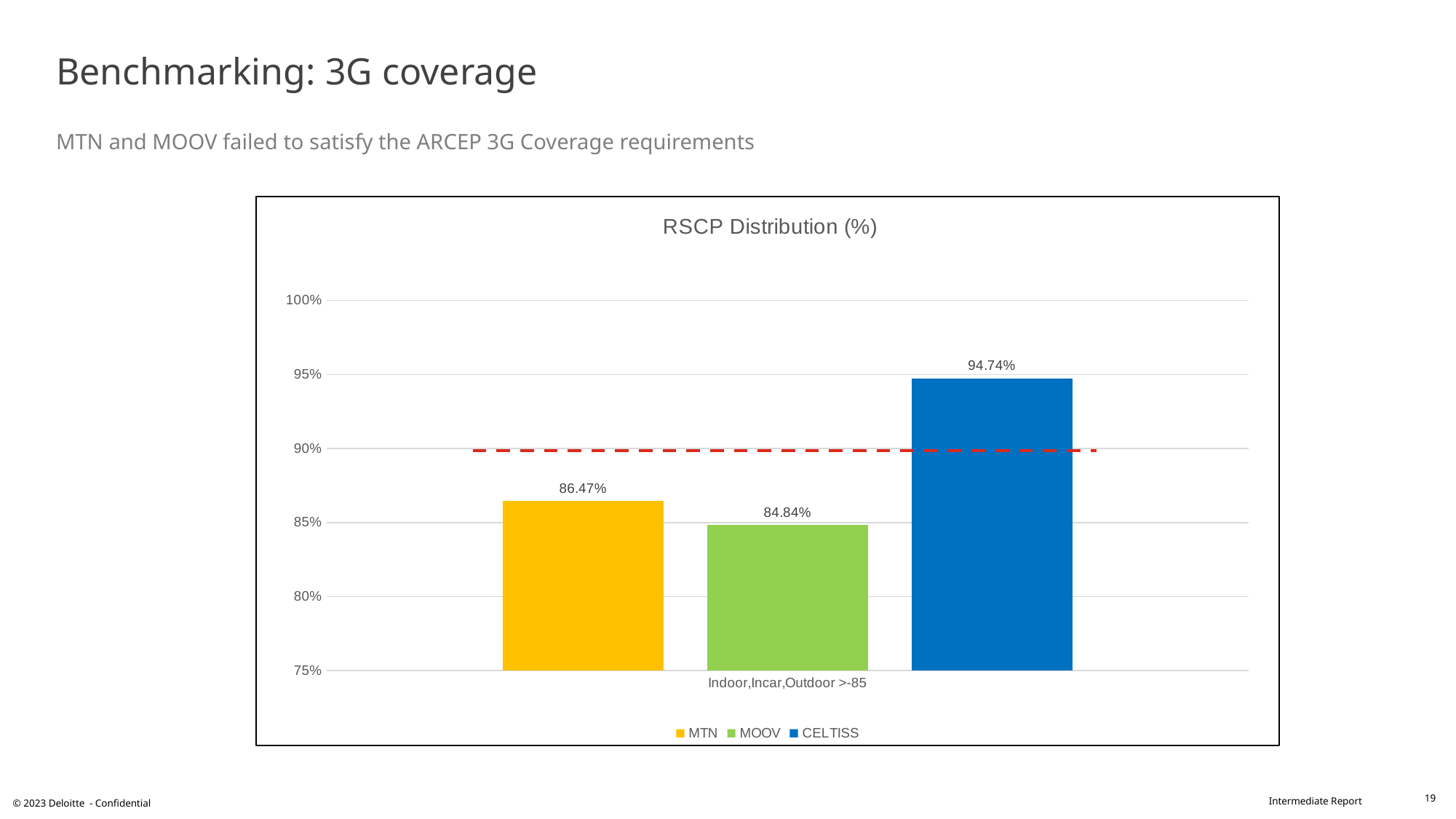
What is the title of the chart? RSCP Distribution (%) Is the value for CELTISS greater or less than 90%? greater Which is larger, the value for MTN or the value for MOOV? MTN What is the RSCP Distribution value for MOOV? 84.84% Which operator has the highest RSCP Distribution value? CELTISS What kind of chart is shown on the slide? Bar chart What is the RSCP Distribution value for MTN? 86.47% What is the RSCP Distribution value for CELTISS? 94.74% How many series does the legend list? 3 Which operator has the lowest RSCP Distribution value? MOOV What is the difference between the CELTISS and MTN values? 8.27% What is the difference between the MTN and MOOV values? 1.63%